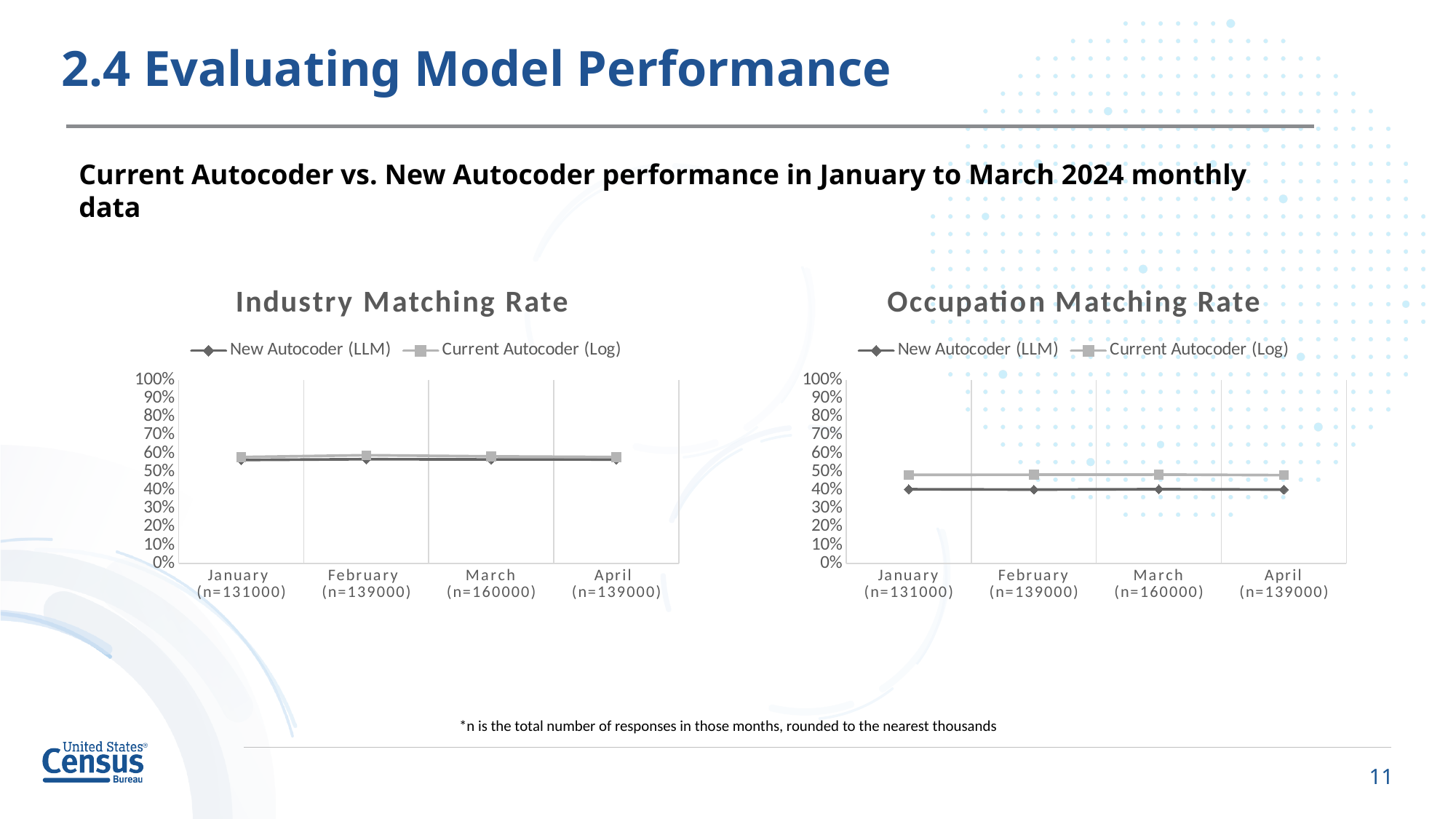
What is the sample size (n) shown for March on the x axis of the Industry Matching Rate chart? n=160000 In the Occupation Matching Rate chart, is the value for New Autocoder (LLM) in March greater or less than 30%? greater How many series does the legend of the Occupation Matching Rate chart list? 2 In the Industry Matching Rate chart, is the value for Current Autocoder (Log) in March greater or less than 70%? less How many months are shown on the x axis of the Industry Matching Rate chart? 4 What kind of chart is the Industry Matching Rate chart? line chart What is the title of the chart on the right side of the slide? Occupation Matching Rate In the Occupation Matching Rate chart, is the value for Current Autocoder (Log) in April greater or less than 40%? greater In the Occupation Matching Rate chart, which series has the higher value in February, New Autocoder (LLM) or Current Autocoder (Log)? Current Autocoder (Log) In the Occupation Matching Rate chart, do the values for Current Autocoder (Log) rise, fall, or stay roughly flat from January to April? roughly flat